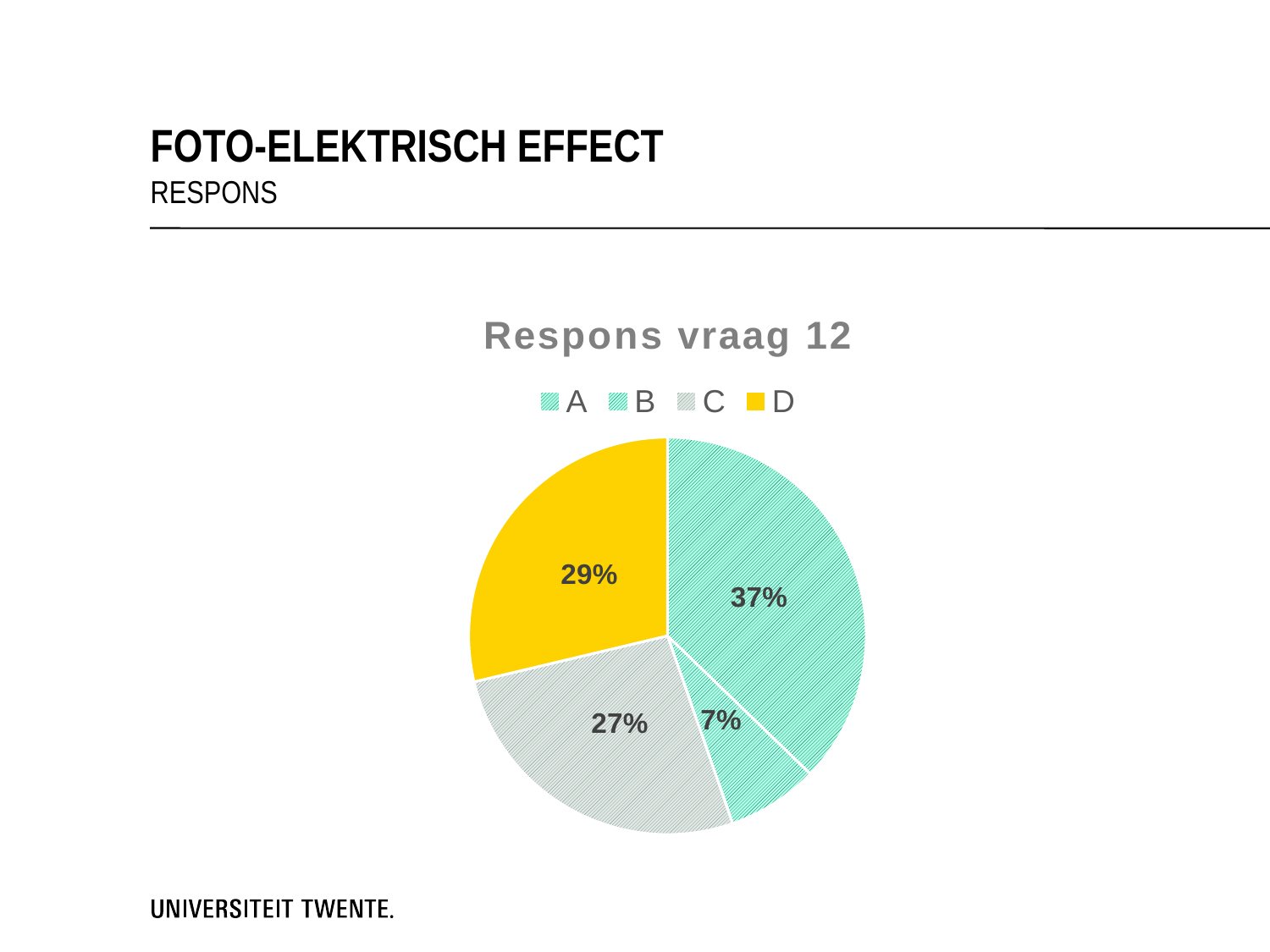
What share of the pie does category C have? 27% Which is larger, the slice for C or the slice for D? D Which category has the smallest slice of the pie? B What share of the pie does category A have? 37% How many categories does the legend list? 4 What kind of chart is shown on the slide? pie chart What is the title of the chart? Respons vraag 12 Which category has the largest slice of the pie? A Which category is shown in solid yellow? D What is the difference in percentage points between category A and category D? 8% What share of the pie does category B have? 7%